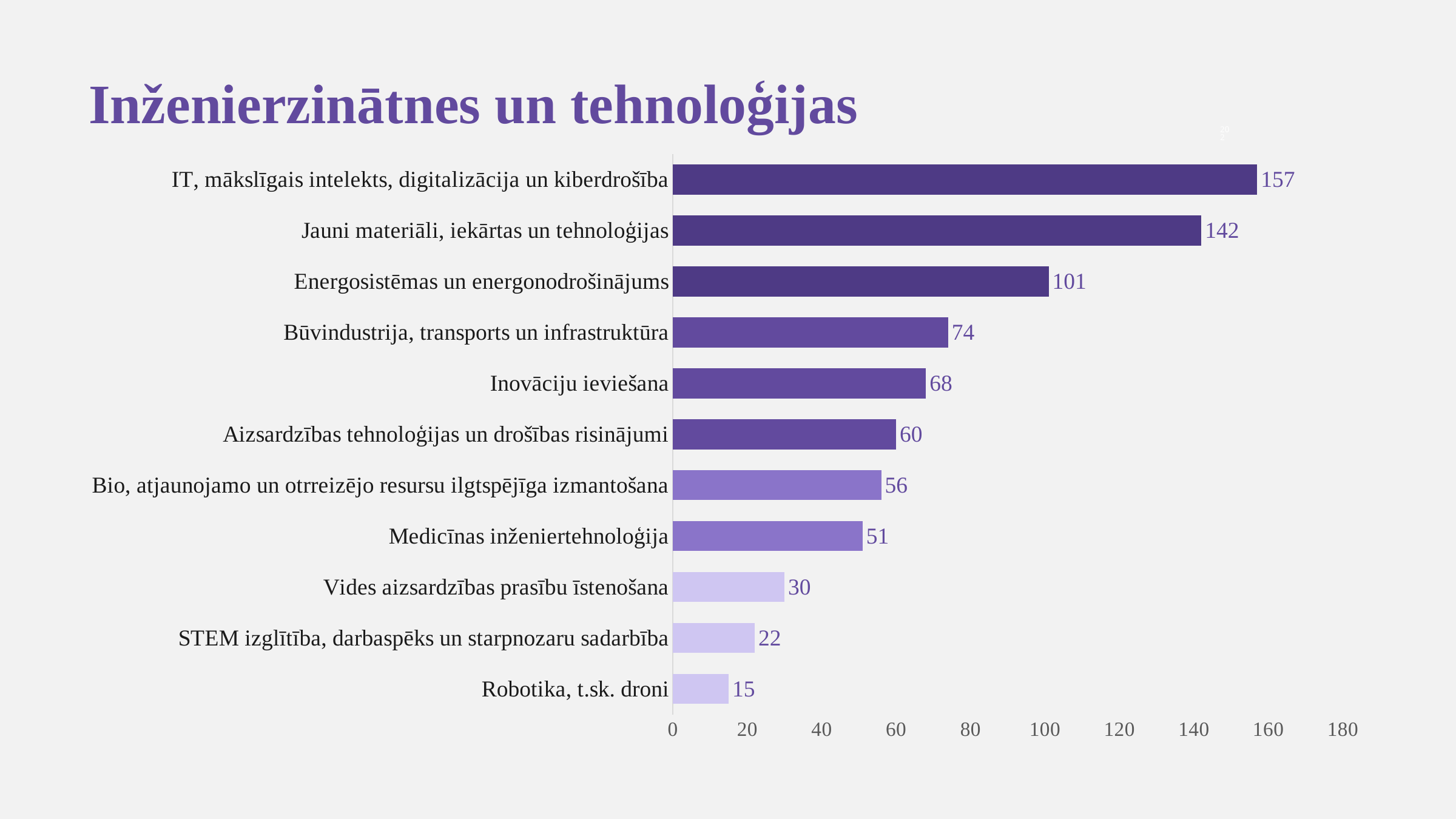
What is the difference between the values for "STEM izglītība, darbaspēks un starpnozaru sadarbība" and "Robotika, t.sk. droni"? 7 How many categories are shown in the chart? 11 What is the difference between the values for "Jauni materiāli, iekārtas un tehnoloģijas" and "Būvindustrija, transports un infrastruktūra"? 68 Is the value for "Vides aizsardzības prasību īstenošana" greater or less than 40? less Which category has the lowest value? Robotika, t.sk. droni Which is larger: the value for "Inovāciju iviešana" or the value for "Aizsardzības tehnoloģijas un drošības risinājumi"? Inovāciju ieviešana What kind of chart is shown on the slide? bar chart What is the value for "Medicīnas inženiertehnoloģija"? 51 What is the value for "IT, mākslīgais intelekts, digitalizācija un kiberdrošība"? 157 Which category has the highest value? IT, mākslīgais intelekts, digitalizācija un kiberdrošība What is the value for "Energosistēmas un energonodrošinājums"? 101 What is the title of the slide? Inženierzinātnes un tehnoloģijas